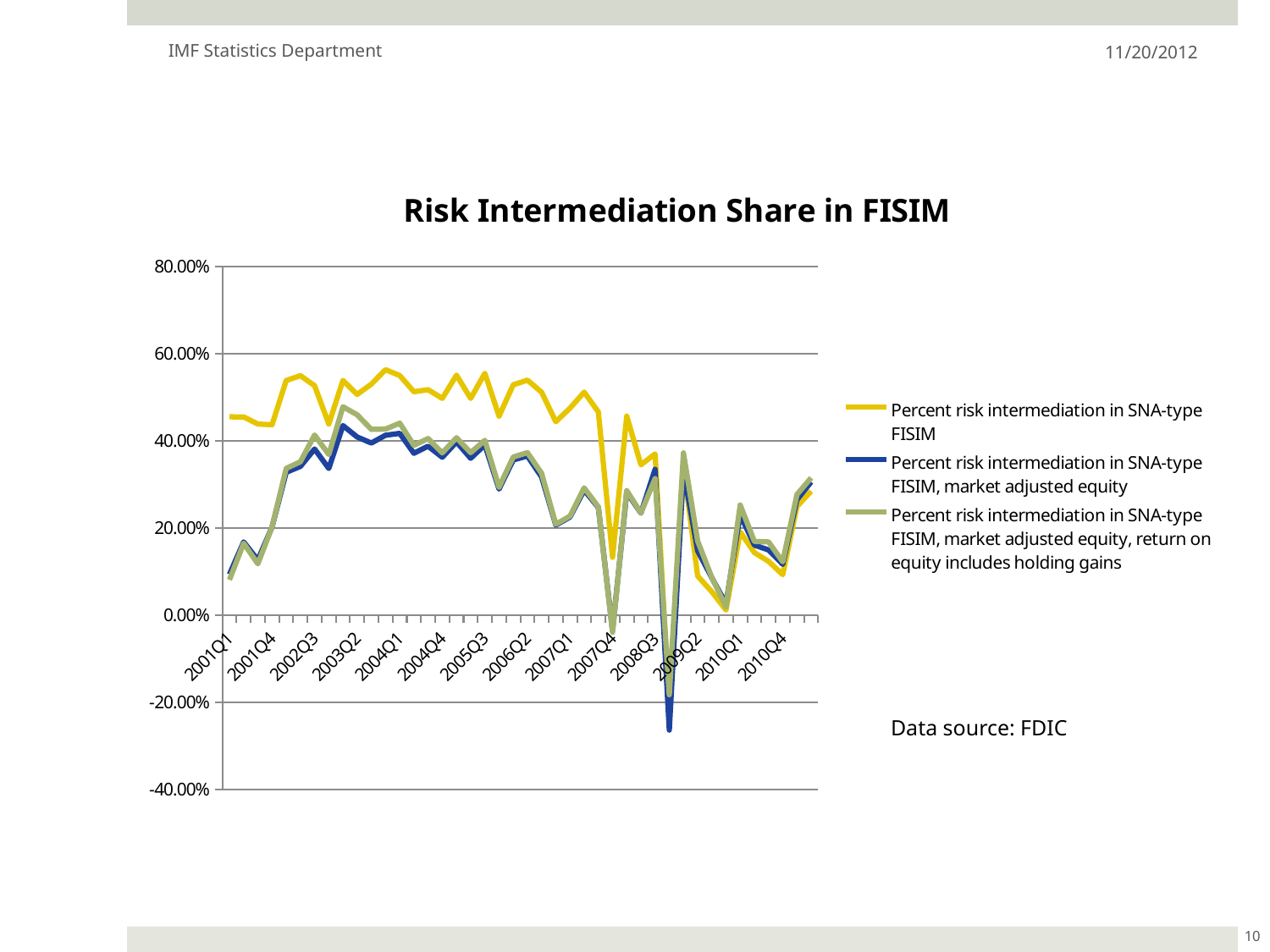
What kind of chart is shown on the slide? Line chart How many labels are shown on the x axis? 14 Is the value of the 'Percent risk intermediation in SNA-type FISIM' series at 2004Q1 greater or less than 60.00%? less At 2004Q1, which is larger: the 'Percent risk intermediation in SNA-type FISIM' series or the 'Percent risk intermediation in SNA-type FISIM, market adjusted equity' series? Percent risk intermediation in SNA-type FISIM What data source is cited for the chart? FDIC Is the value of the 'Percent risk intermediation in SNA-type FISIM' series at 2001Q1 greater or less than 40.00%? greater Which series reaches the lowest value anywhere on the chart? Percent risk intermediation in SNA-type FISIM, market adjusted equity Is the value of the 'Percent risk intermediation in SNA-type FISIM, market adjusted equity' series at 2009Q2 greater or less than -20.00%? greater How many series does the legend list? 3 What is the title of the chart? Risk Intermediation Share in FISIM Does the 'Percent risk intermediation in SNA-type FISIM' series rise or fall between 2007Q1 and 2007Q4? fall